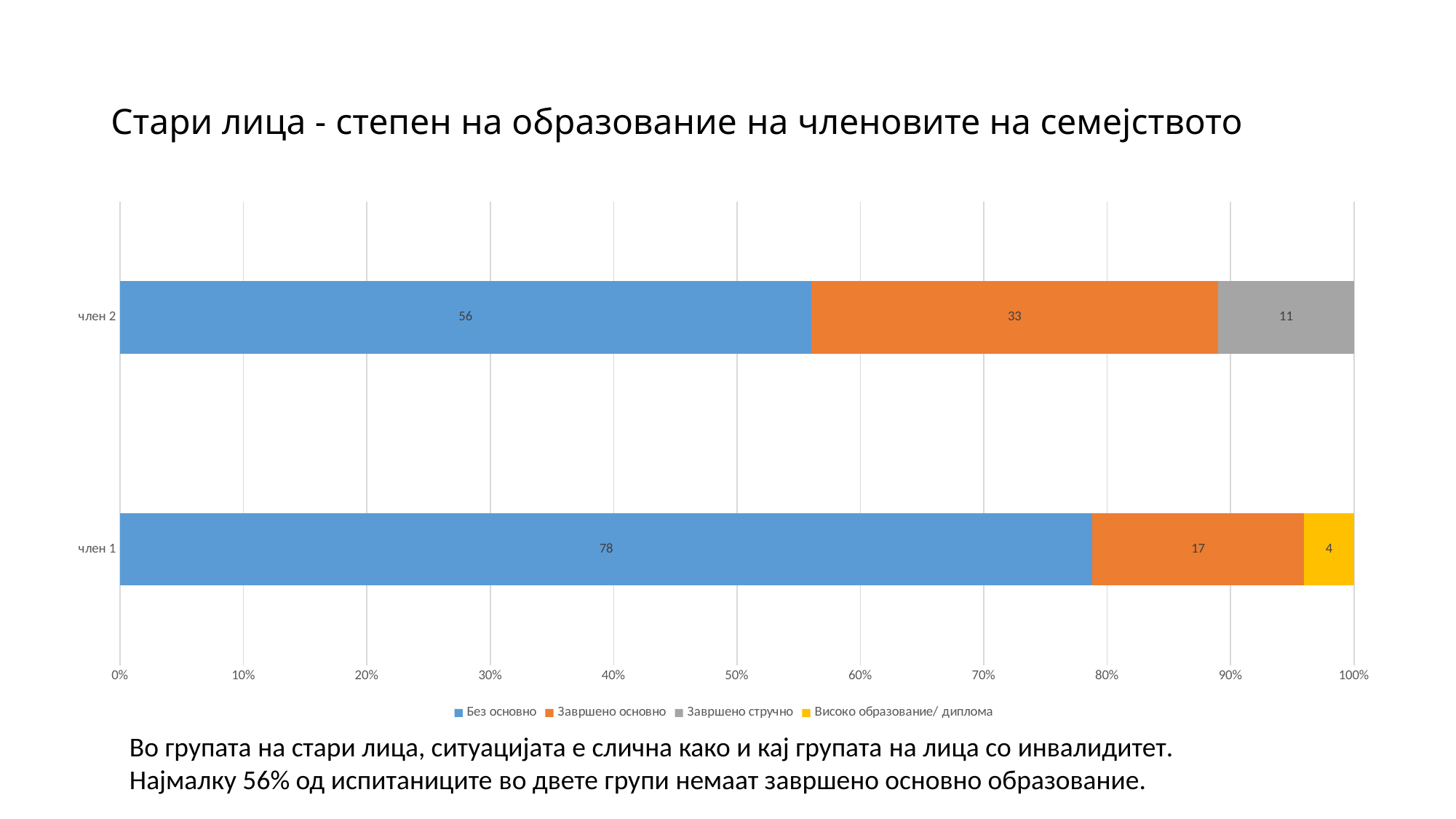
Which series has the highest value for член 2? Без основно What is the value for Завршено основно for член 2? 33 How many categories are shown on the vertical axis? 2 Which series has the lowest value for член 1? Високо образование/ диплома What is the value for Високо образование/ диплома for член 1? 4 How many series does the legend list? 4 What is the value for Завршено стручно for член 2? 11 What is the difference between the Завршено основно values for член 2 and член 1? 16 What kind of chart is shown on the slide? Stacked bar chart Which category has the higher value for Без основно, член 1 or член 2? член 1 What is the difference between the Без основно values for член 1 and член 2? 22 What is the value for Без основно for член 1? 78